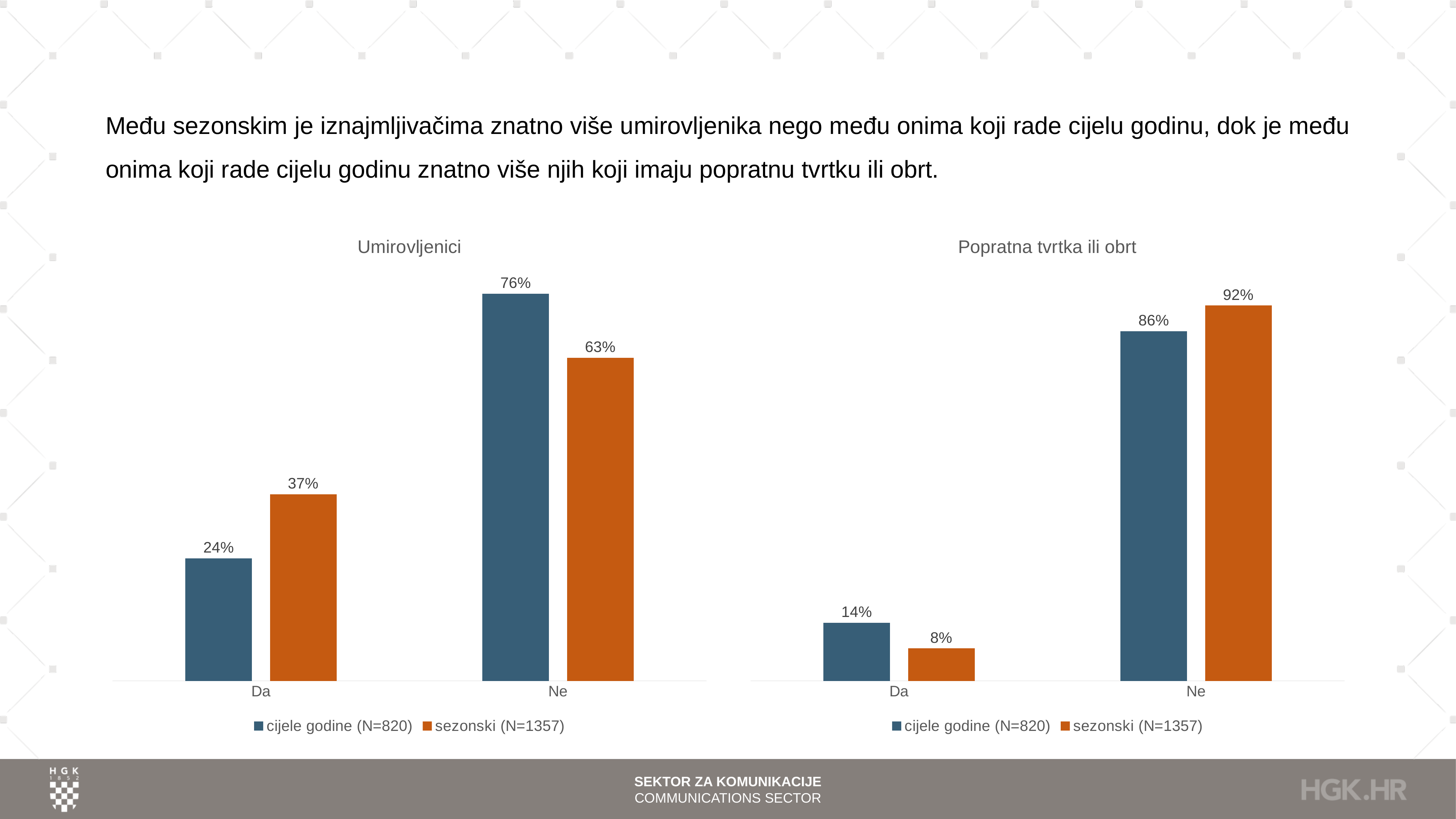
In the 'Umirovljenici' chart, what is the value for 'sezonski (N=1357)' in the 'Ne' category? 63% In the 'Popratna tvrtka ili obrt' chart, what is the value for 'sezonski (N=1357)' in the 'Da' category? 8% In the 'Umirovljenici' chart, what is the difference between the 'sezonski (N=1357)' and 'cijele godine (N=820)' values for 'Da'? 13% How many series does the legend of the 'Umirovljenici' chart list? 2 In the 'Popratna tvrtka ili obrt' chart, which bar has the highest value? sezonski (N=1357) for Ne (92%) In the 'Popratna tvrtka ili obrt' chart, which series has the larger value for 'Da'? cijele godine (N=820) In the 'Umirovljenici' chart, which bar has the lowest value? cijele godine (N=820) for Da (24%) In the 'Popratna tvrtka ili obrt' chart, what is the value for 'cijele godine (N=820)' in the 'Ne' category? 86% In the 'Popratna tvrtka ili obrt' chart, what is the difference between the 'sezonski (N=1357)' and 'cijele godine (N=820)' values for 'Ne'? 6% In the 'Umirovljenici' chart, which series has the larger value for 'Ne'? cijele godine (N=820) In the 'Umirovljenici' chart, what is the value for 'cijele godine (N=820)' in the 'Da' category? 24% What kind of chart is the 'Popratna tvrtka ili obrt' chart? Bar chart